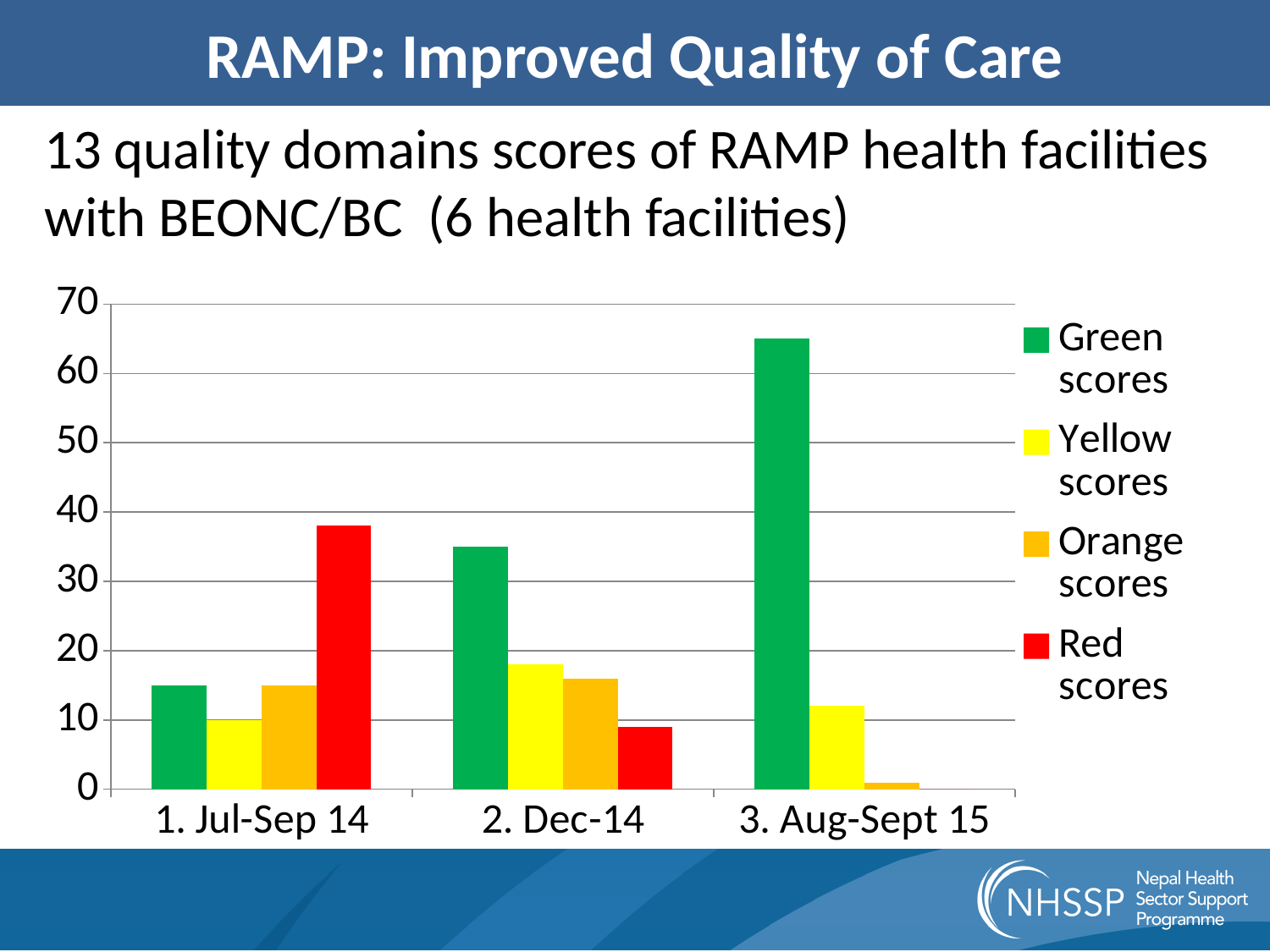
How many time periods are shown on the x axis? 3 Is the value for Red scores in 1. Jul-Sep 14 greater or less than 30? greater Do the Red scores rise or fall across the three periods from 1. Jul-Sep 14 to 3. Aug-Sept 15? fall Is the value for Green scores in 3. Aug-Sept 15 greater or less than 60? greater Which series has the highest value in the 1. Jul-Sep 14 period? Red scores Which series has the lowest value in the 2. Dec-14 period? Red scores Which is larger: Green scores in 2. Dec-14 or Green scores in 1. Jul-Sep 14? Green scores in 2. Dec-14 Is the value for Green scores in 2. Dec-14 greater or less than 40? less What kind of chart is shown on the slide? bar chart How many series does the legend list? 4 Do the Green scores rise or fall across the three periods from 1. Jul-Sep 14 to 3. Aug-Sept 15? rise Which series has the highest value in the 3. Aug-Sept 15 period? Green scores